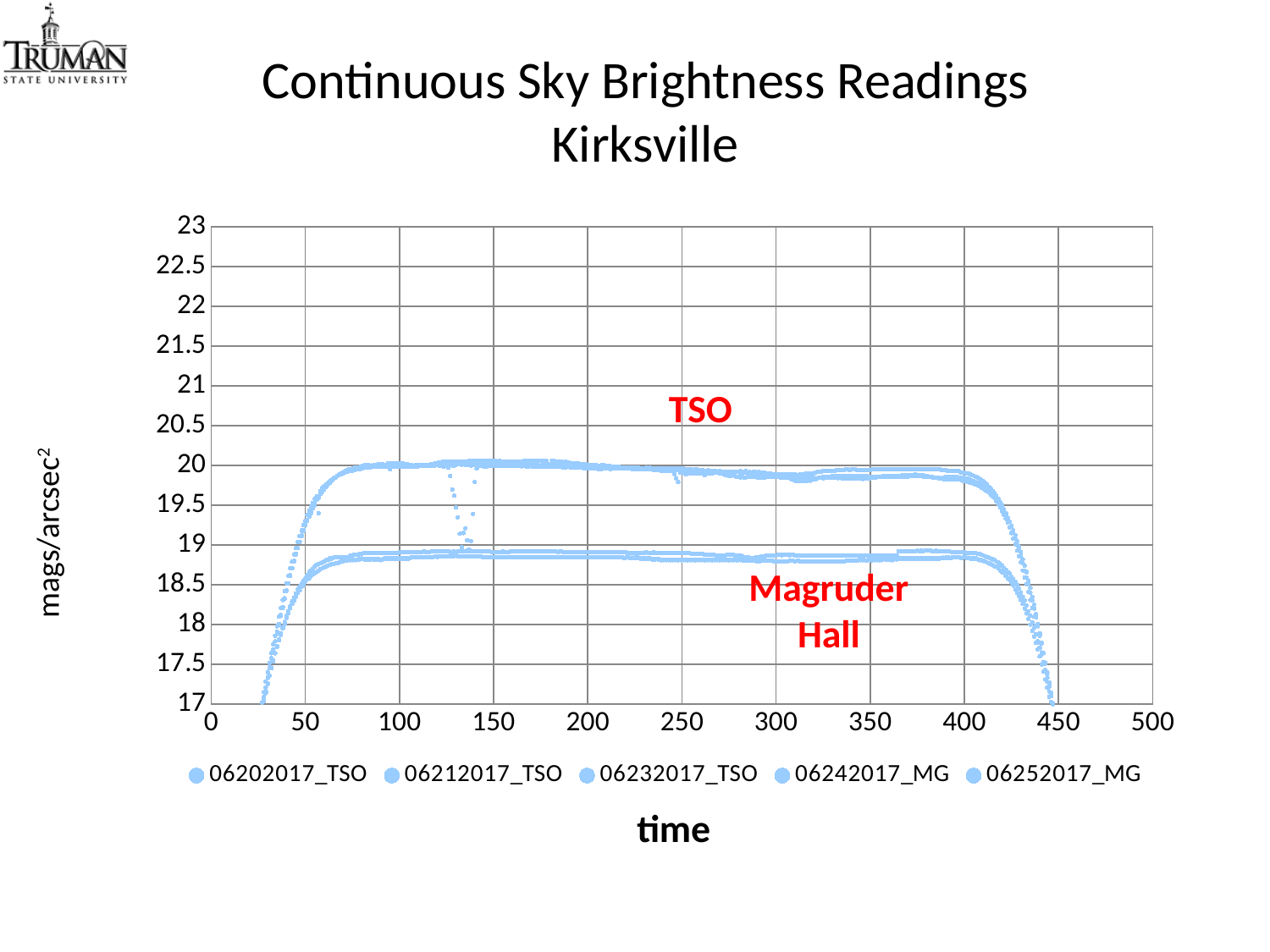
Between time 400 and 450, do the readings rise or fall? fall Is the TSO reading at time 100 greater or less than 20.5? less What is the title of the chart? Continuous Sky Brightness Readings Kirksville What is the label on the y axis? mags/arcsec² Which location shows higher sky brightness readings across the plateau, TSO or Magruder Hall? TSO What kind of chart is shown on the slide? scatter chart How many of the legend series are labelled MG? 2 Is the Magruder Hall reading at time 200 greater or less than 19? less How many of the legend series are labelled TSO? 3 Is the Magruder Hall reading at time 300 greater or less than 18.5? greater How many series does the legend list? 5